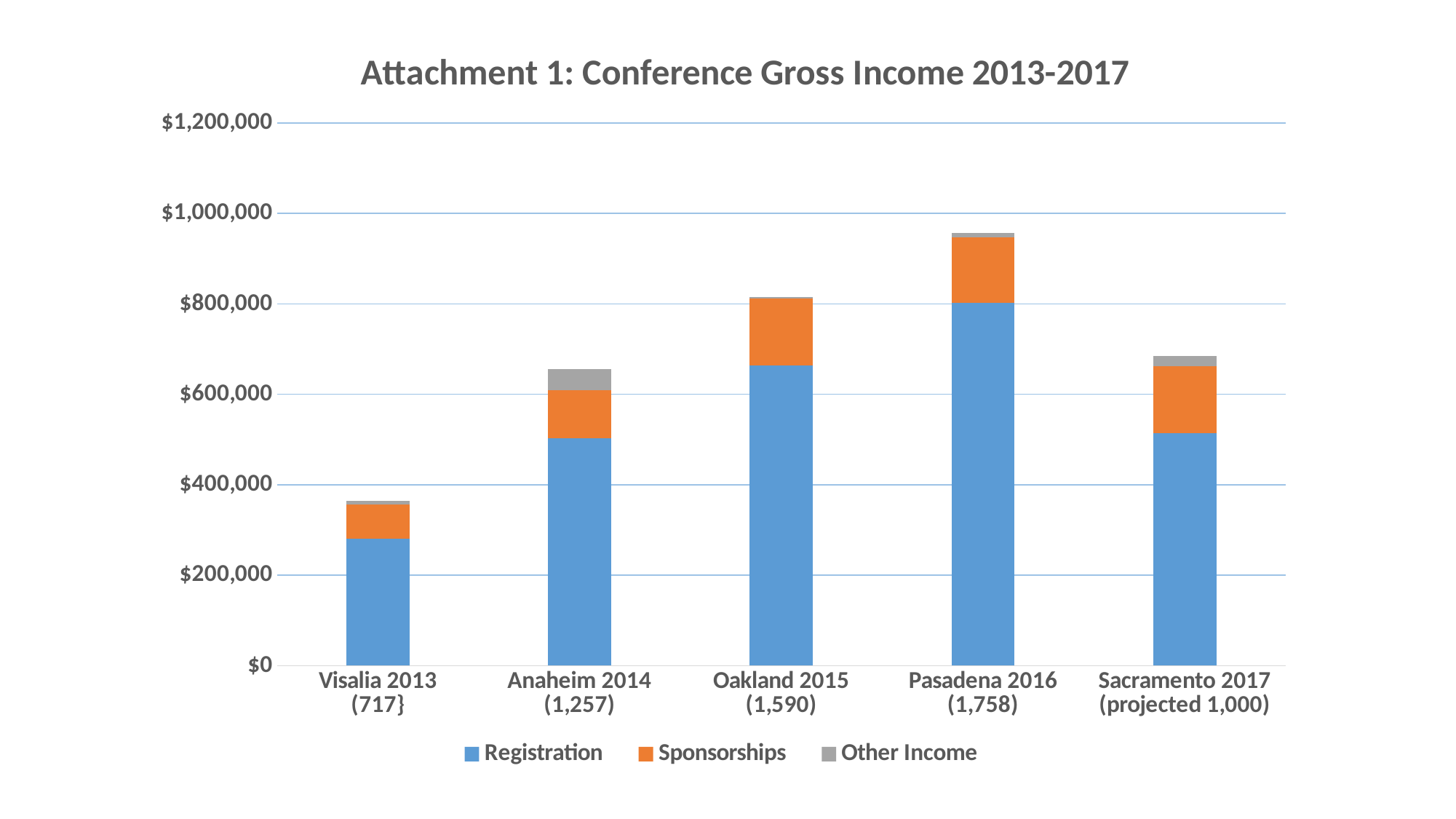
Is the total gross income for Sacramento 2017 greater or less than $800,000? less How many conferences (bars) are shown on the x axis? 5 Is the total gross income for Pasadena 2016 greater or less than $800,000? greater Which conference has the lowest total gross income? Visalia 2013 What kind of chart is shown on the slide? Stacked bar chart Which has the larger total gross income, Oakland 2015 or Anaheim 2014? Oakland 2015 How does total gross income change from Visalia 2013 through Pasadena 2016? It rises each year Is the Registration income for Oakland 2015 greater or less than $600,000? greater What is the title of the chart? Attachment 1: Conference Gross Income 2013-2017 Which conference has the highest total gross income? Pasadena 2016 How many series does the legend list? 3